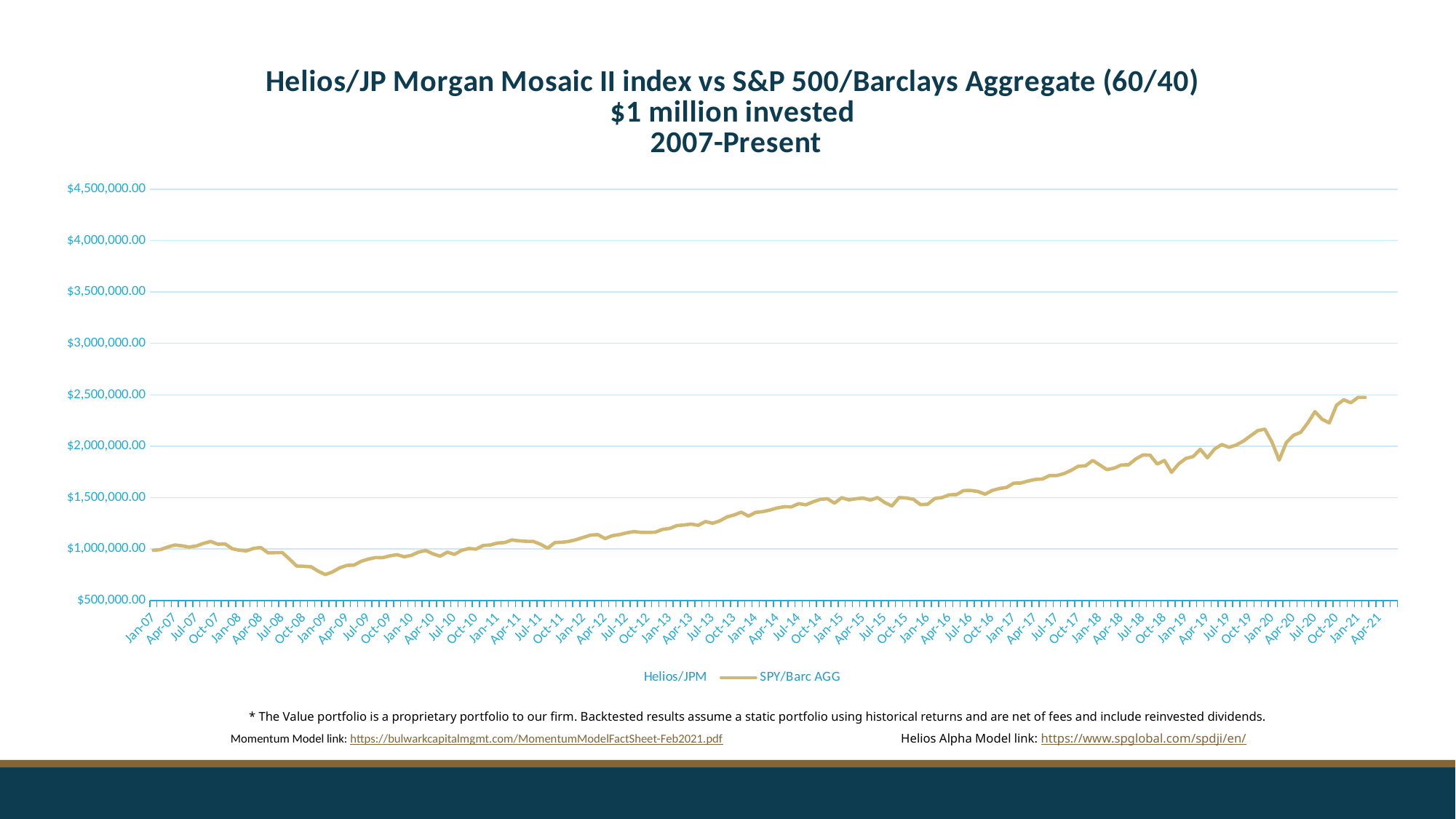
What is the highest value shown on the y axis? $4,500,000.00 In which year does the SPY/Barc AGG line reach its lowest point? 2009 Does the SPY/Barc AGG line generally rise or fall from Jan-07 to Apr-21? rise Is the value of the SPY/Barc AGG line at Jan-14 greater or less than $1,500,000.00? less Is the value of the SPY/Barc AGG line at Jan-12 greater or less than $1,000,000.00? greater Is the value of the SPY/Barc AGG line at Jan-09 greater or less than $1,000,000.00? less Which two series are listed in the legend? Helios/JPM and SPY/Barc AGG Is the SPY/Barc AGG value at Jan-21 larger or smaller than at Jan-19? larger What kind of chart is shown on the slide? line chart How many series does the legend list? 2